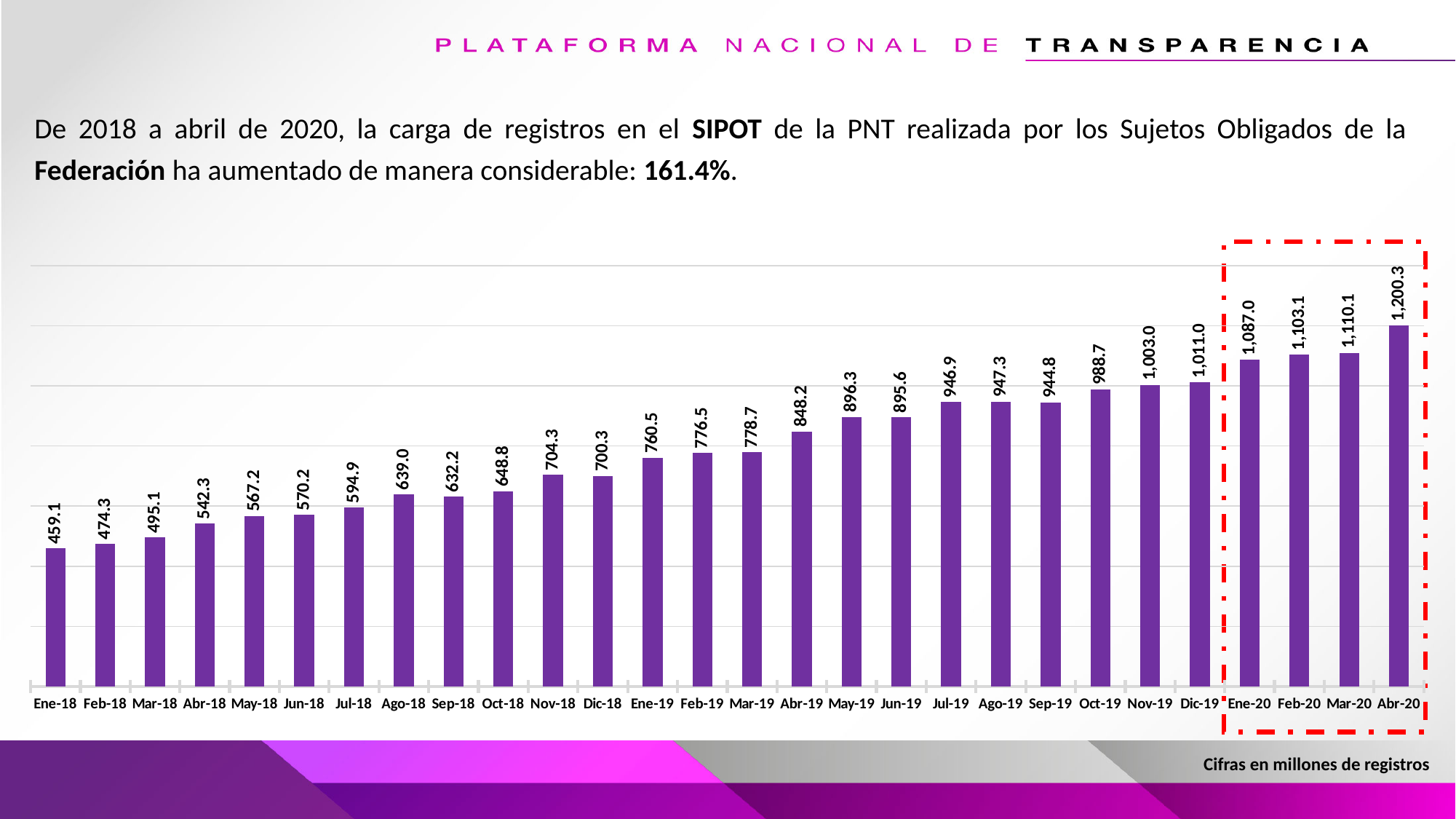
What is the value for Abr-20? 1,200.3 Do the values generally rise or fall from Ene-18 to Abr-20? rise How many months are plotted on the chart? 28 What is the value for Jul-19? 946.9 What is the difference between the values for Abr-20 and Ene-18? 741.2 What is the difference between the values for Abr-20 and Mar-20? 90.2 Which is larger, the value for Ago-18 or the value for Sep-18? Ago-18 What type of chart is shown on the slide? bar chart What is the value for Ene-18? 459.1 Which month has the highest value? Abr-20 Which month has the lowest value? Ene-18 What is the value for Dic-19? 1,011.0